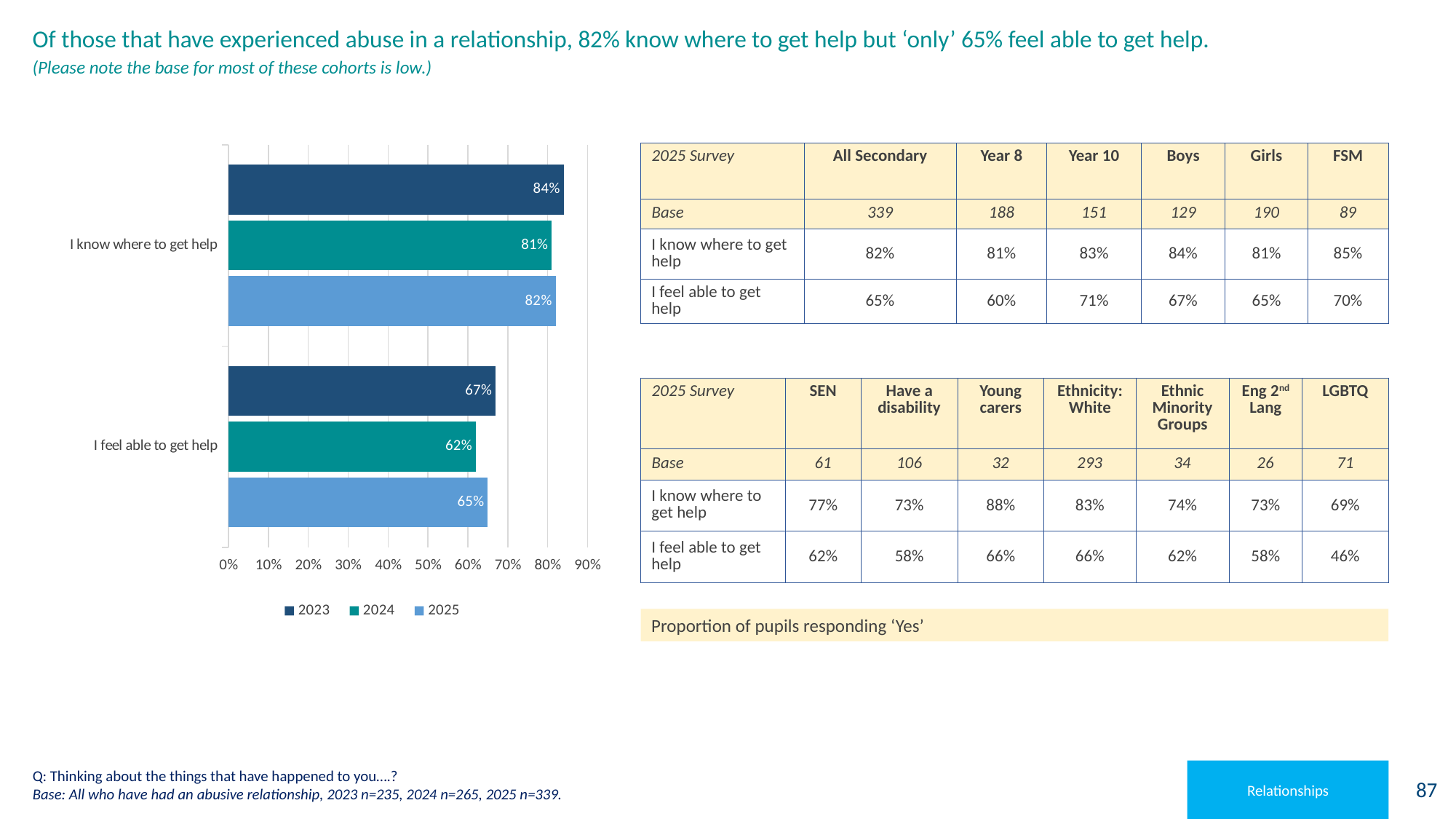
What is the 2024 value for 'I feel able to get help'? 62% What is the difference between the 2025 values for 'I know where to get help' and 'I feel able to get help'? 17% What kind of chart is shown on the slide? Bar chart Which is larger: the 2024 value for 'I know where to get help' or the 2025 value for 'I know where to get help'? 2025 Which year has the lowest value for 'I feel able to get help'? 2024 Which year has the highest value for 'I know where to get help'? 2023 What is the maximum value shown on the chart's x axis? 90% What is the 2023 value for 'I feel able to get help'? 67% What is the 2025 value for 'I know where to get help'? 82% How many series does the legend list? 3 How many categories are shown on the chart? 2 Is the 2023 value for 'I feel able to get help' greater or less than 60%? greater